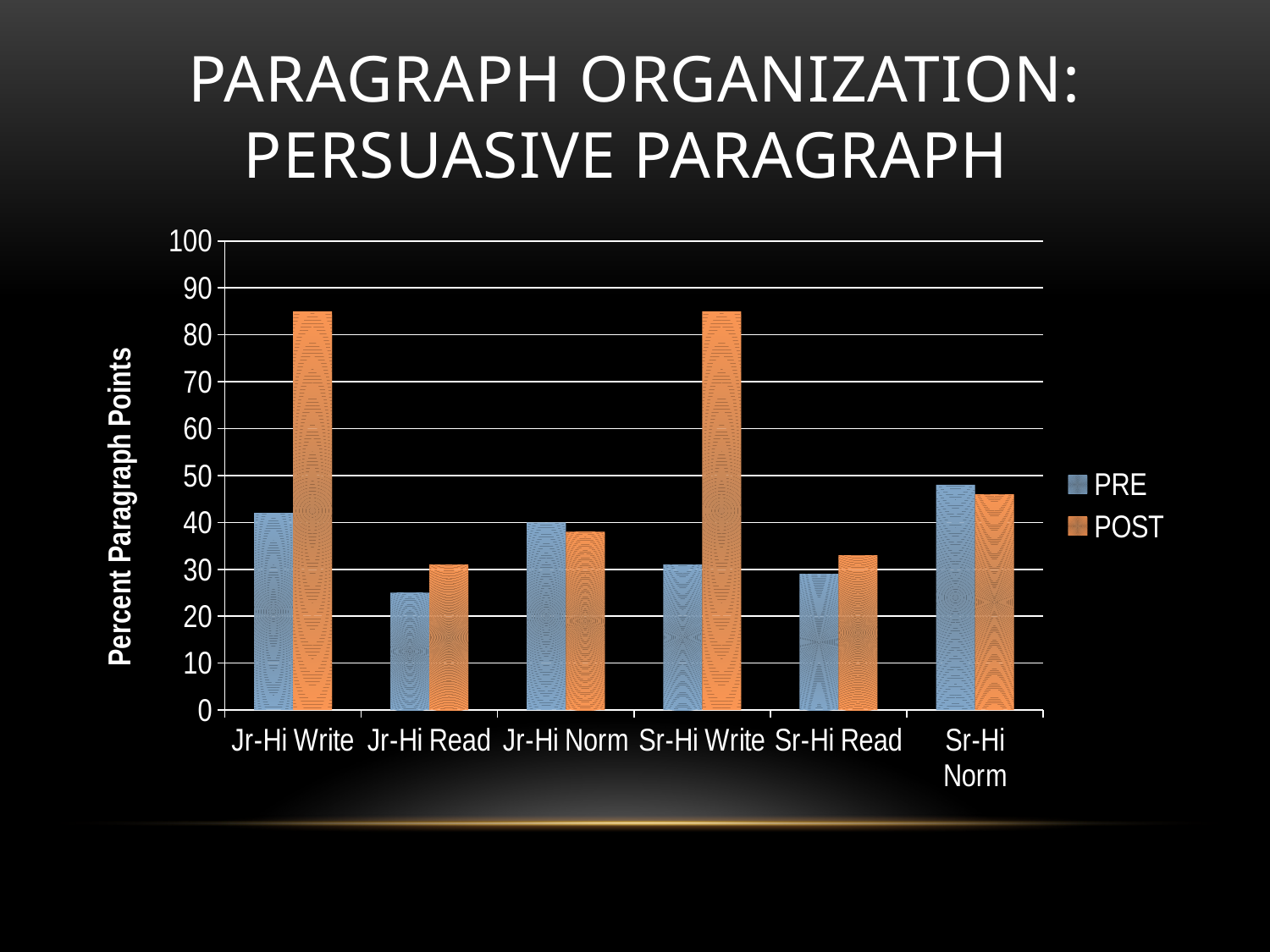
How many categories are shown on the x axis of the chart? 6 For Sr-Hi Write, which is larger, the PRE value or the POST value? POST Which category has the highest PRE value? Sr-Hi Norm Which category has the lowest PRE value? Jr-Hi Read Is the PRE value for Sr-Hi Norm greater or less than 40? greater What is the title of the vertical axis of the chart? Percent Paragraph Points What kind of chart is shown on the slide? bar chart Is the PRE value for Jr-Hi Read greater or less than 30? less Is the POST value for Jr-Hi Write greater or less than 80? greater What are the two series named in the chart's legend? PRE and POST How many series does the chart's legend list? 2